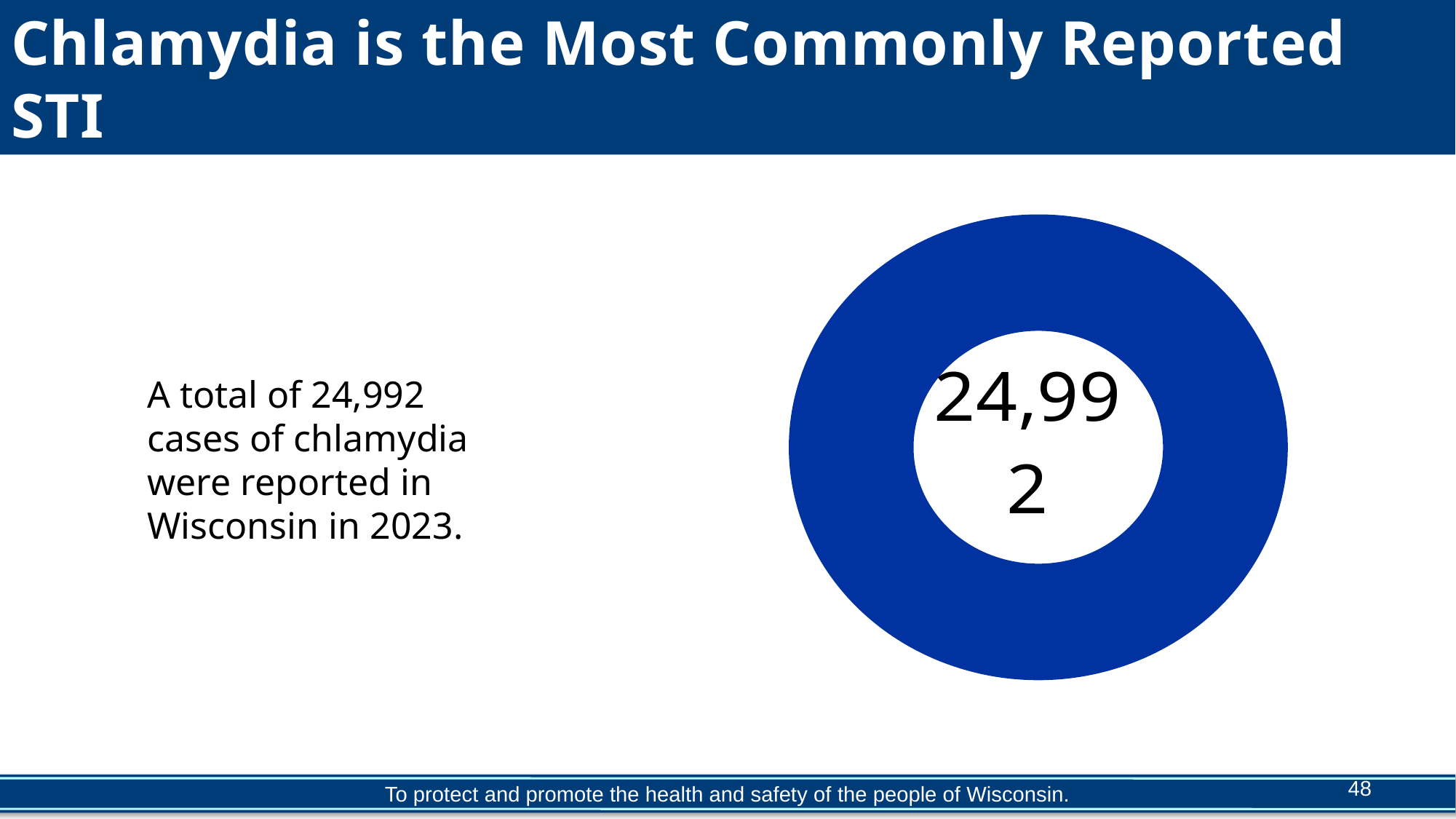
Does the donut chart include a legend? No What share of the donut chart does the single blue slice occupy? 100% Is the value shown in the donut chart greater or less than 30,000? less Is the value shown in the donut chart greater or less than 20,000? greater What number is printed in the center of the donut chart? 24,992 What colour is the ring of the donut chart? Blue What kind of chart is shown on the slide? Donut chart How many slices does the donut chart have? 1